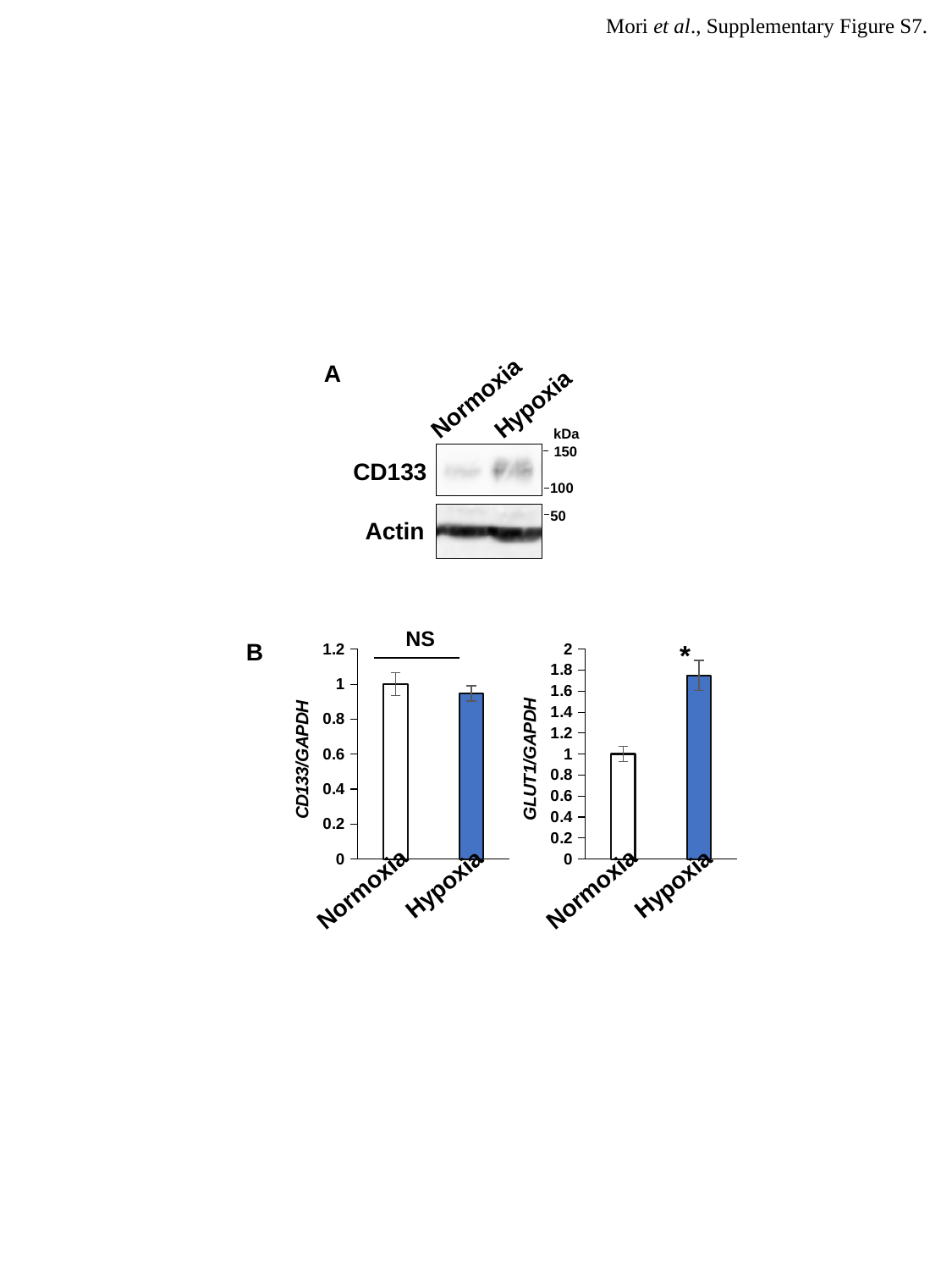
How many categories are shown on the x axis of the GLUT1/GAPDH chart? 2 What annotation is written above the bars in the CD133/GAPDH chart? NS In the GLUT1/GAPDH chart, which category has the higher value, Normoxia or Hypoxia? Hypoxia In the GLUT1/GAPDH chart, which category has the lowest value? Normoxia In the GLUT1/GAPDH chart, what is the value for Normoxia? 1 In the GLUT1/GAPDH chart, is the value for Hypoxia greater or less than 2? less In the CD133/GAPDH chart, what is the value for Normoxia? 1 What is the y-axis label of the right-hand chart in panel B? GLUT1/GAPDH In the CD133/GAPDH chart, is the value for Hypoxia greater or less than 0.8? greater What kind of chart is the CD133/GAPDH chart on the left of panel B? bar chart In the GLUT1/GAPDH chart, is the value for Hypoxia greater or less than 1.6? greater